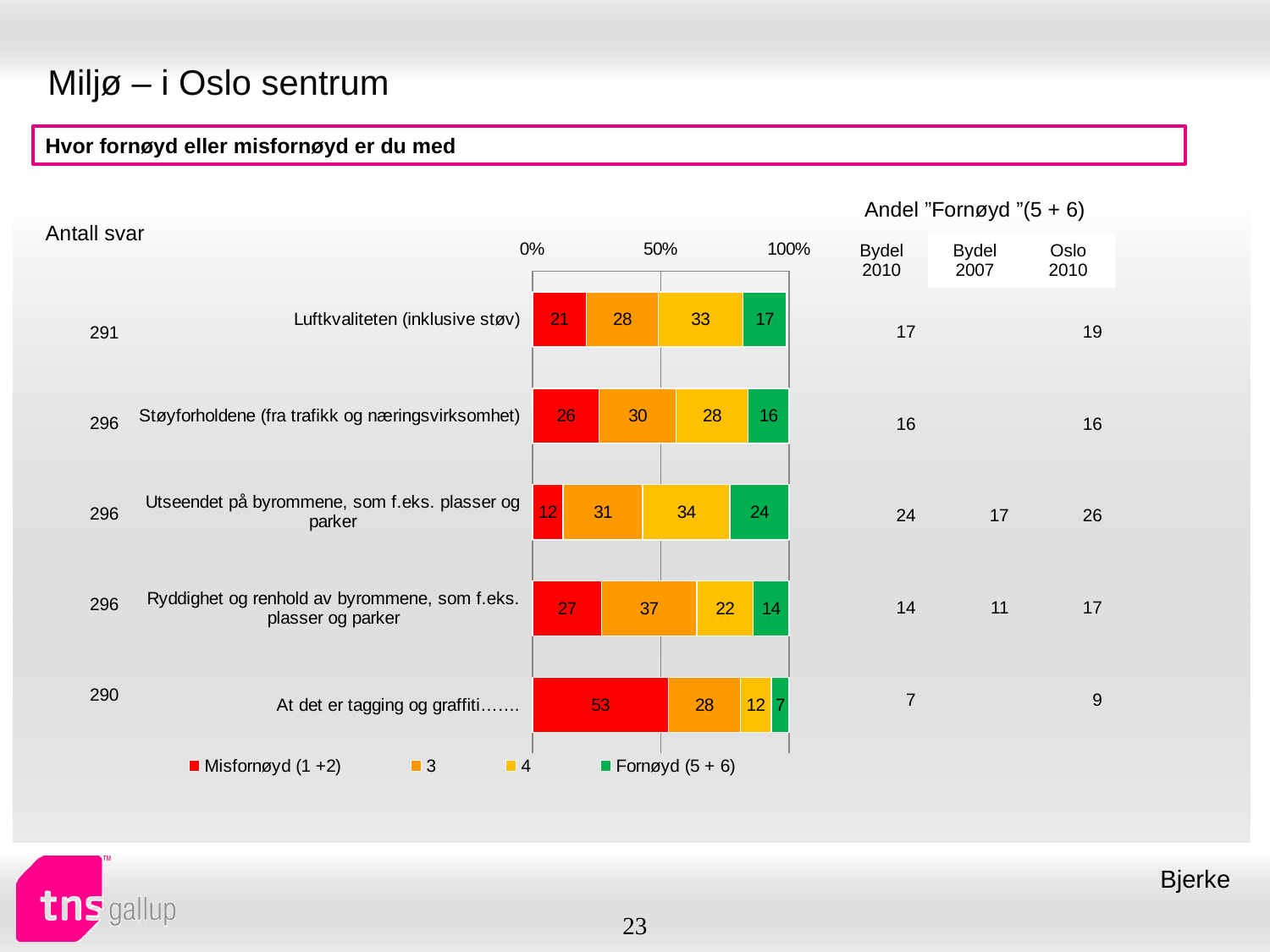
How many categories are shown in the chart? 5 What is the total of the stacked bar for "Støyforholdene (fra trafikk og næringsvirksomhet)"? 100 Which is larger: the "Fornøyd (5 + 6)" value for "Støyforholdene (fra trafikk og næringsvirksomhet)" or for "Ryddighet og renhold av byrommene, som f.eks. plasser og parker"? Støyforholdene (fra trafikk og næringsvirksomhet) Which category has the lowest "Misfornøyd (1 +2)" value? Utseendet på byrommene, som f.eks. plasser og parker How many series does the legend list? 4 What is the value of "Fornøyd (5 + 6)" for "Luftkvaliteten (inklusive støv)"? 17 What kind of chart is shown on the slide? Stacked bar chart What is the value of series "3" for "Ryddighet og renhold av byrommene, som f.eks. plasser og parker"? 37 What is the difference between the "Misfornøyd (1 +2)" values for "At det er tagging og graffiti…" and "Luftkvaliteten (inklusive støv)"? 32 What is the value of "Misfornøyd (1 +2)" for "At det er tagging og graffiti…"? 53 What colour represents the "Fornøyd (5 + 6)" series in the chart? Green Which category has the highest "Fornøyd (5 + 6)" value? Utseendet på byrommene, som f.eks. plasser og parker